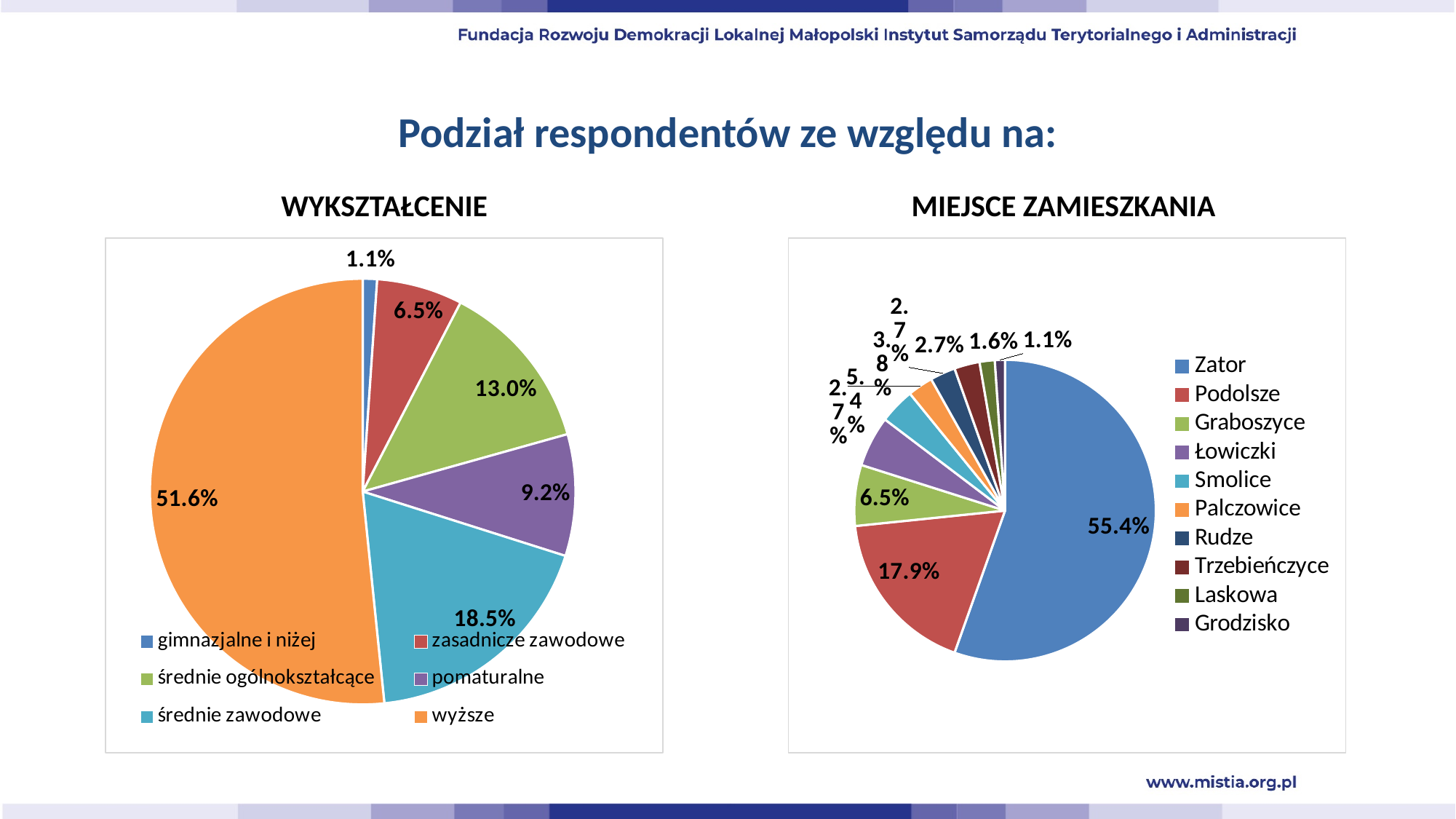
On the MIEJSCE ZAMIESZKANIA chart, what is the difference between Podolsze and Graboszyce? 11.4% On the MIEJSCE ZAMIESZKANIA chart, what is the value for Podolsze? 17.9% What type of chart is the MIEJSCE ZAMIESZKANIA chart? pie chart How many places are listed in the legend of the MIEJSCE ZAMIESZKANIA chart? 10 On the WYKSZTAŁCENIE chart, which category has the smallest share? gimnazjalne i niżej How many categories does the WYKSZTAŁCENIE chart show? 6 On the WYKSZTAŁCENIE chart, what is the difference between średnie ogólnokształcące and pomaturalne? 3.8% On the WYKSZTAŁCENIE chart, what share of respondents have wyższe education? 51.6% On the MIEJSCE ZAMIESZKANIA chart, what is the share for Zator? 55.4% On the WYKSZTAŁCENIE chart, what is the value for średnie zawodowe? 18.5% On the WYKSZTAŁCENIE chart, which is larger: zasadnicze zawodowe or pomaturalne? pomaturalne On the MIEJSCE ZAMIESZKANIA chart, which place has the largest share? Zator